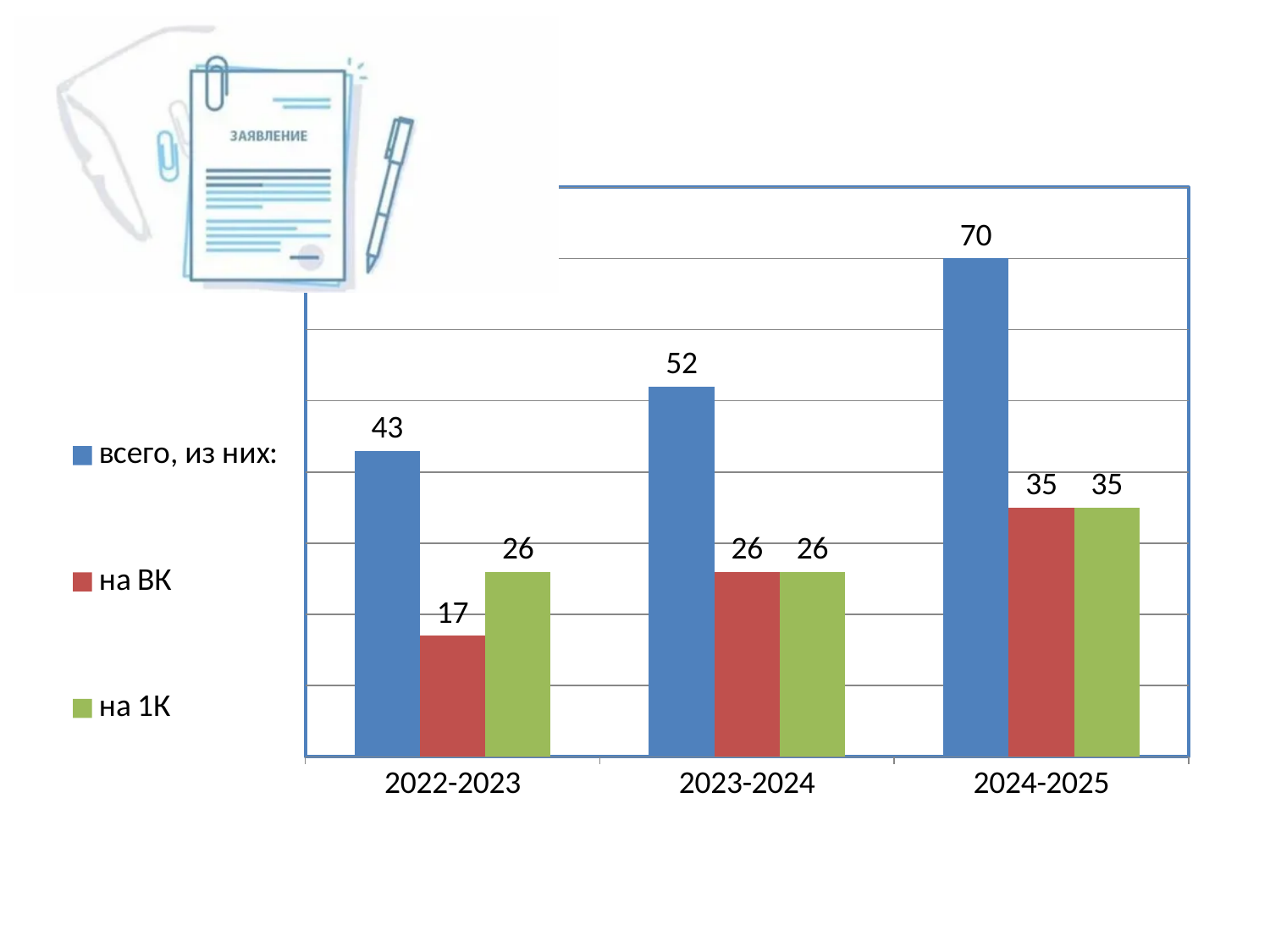
Which period has the highest value for 'всего, из них:'? 2024-2025 Which is larger in 2022-2023: 'на ВК' or 'на 1К'? на 1К What is the value of 'на 1К' for 2023-2024? 26 What is the value of 'всего, из них:' for 2024-2025? 70 How many periods are shown on the x axis? 3 Do the values for 'всего, из них:' rise or fall from 2022-2023 to 2024-2025? rise What colour represents the series 'на 1К' in the legend? green What kind of chart is shown on the slide? bar chart Which period has the lowest value for 'на ВК'? 2022-2023 What is the value of 'на ВК' for 2022-2023? 17 What is the difference between 'всего, из них:' for 2024-2025 and 2022-2023? 27 How many series does the legend list? 3